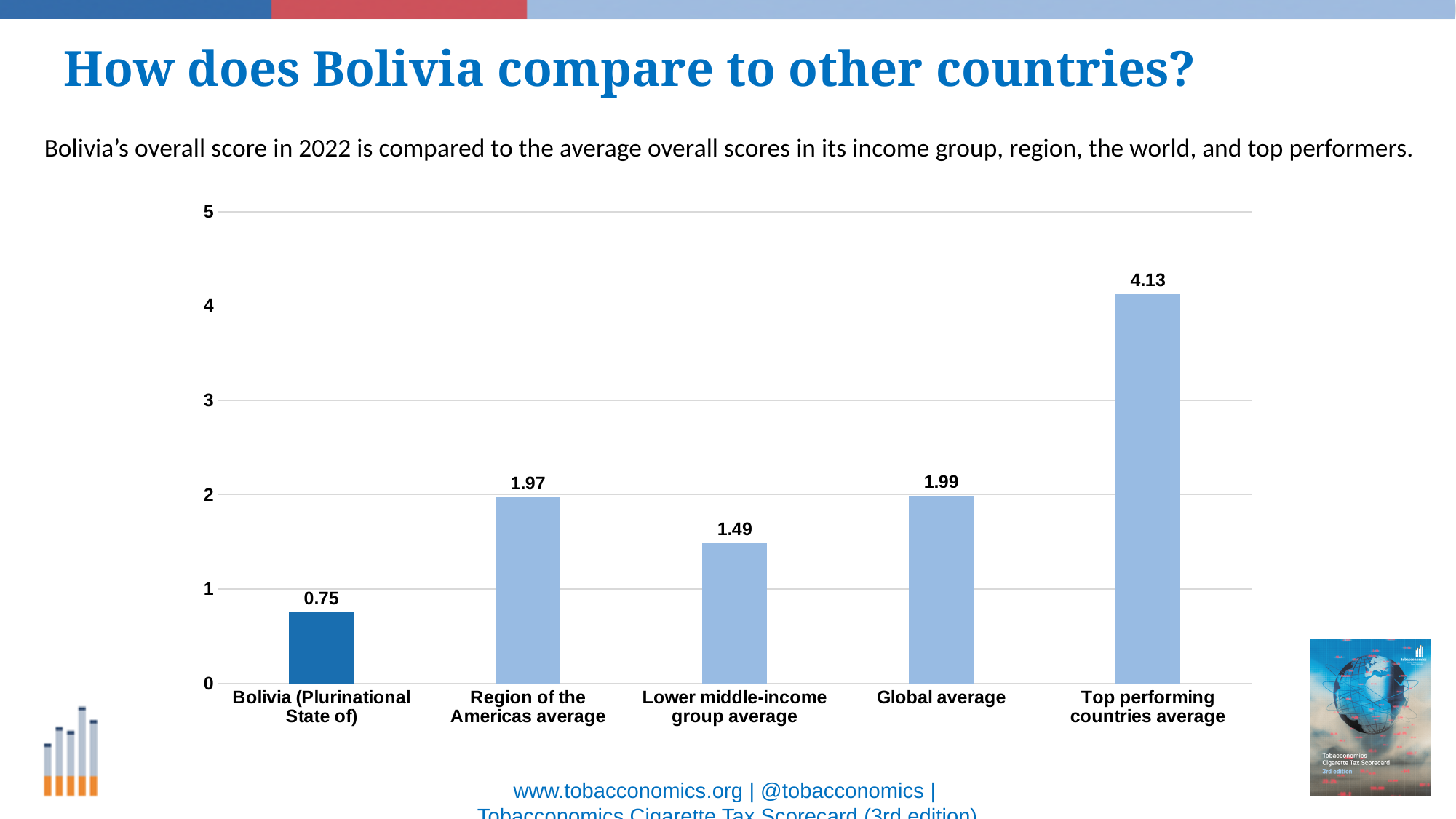
Which bar is shown in a darker blue than the others? Bolivia (Plurinational State of) What is the value for Lower middle-income group average? 1.49 What is the value for Global average? 1.99 What is the value for Region of the Americas average? 1.97 What is the difference between the Top performing countries average and Bolivia (Plurinational State of)? 3.38 Which category has the highest value? Top performing countries average Which is larger, the Lower middle-income group average or the Region of the Americas average? Region of the Americas average Which category has the lowest value? Bolivia (Plurinational State of) What is the value for Bolivia (Plurinational State of)? 0.75 What kind of chart is shown on the slide? Bar chart What is the value for Top performing countries average? 4.13 How many categories are shown in the chart? 5